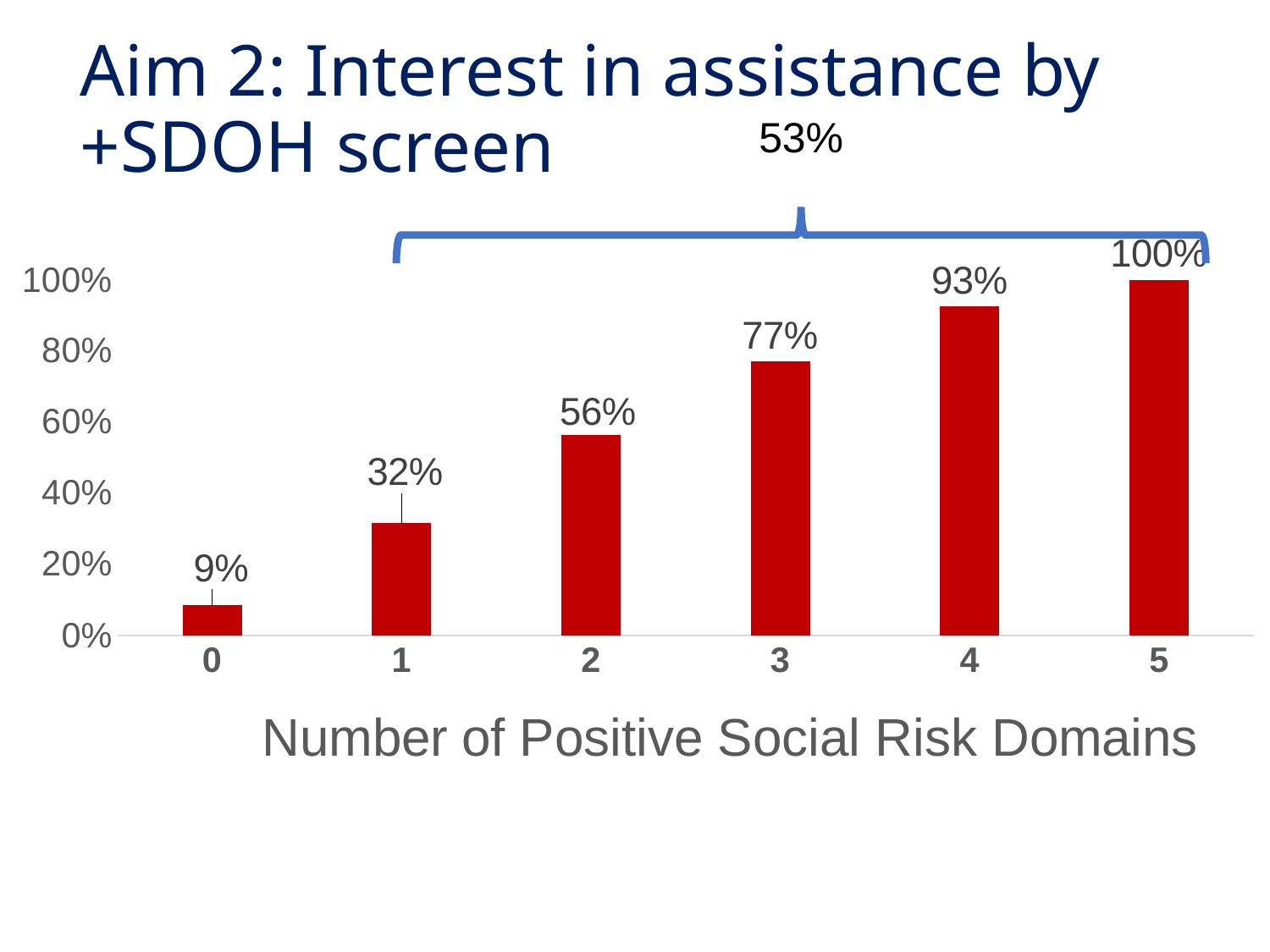
Which number of positive social risk domains has the highest value? 5 Which number of positive social risk domains has the lowest value? 0 What is the value for 3 positive social risk domains? 77% What kind of chart is shown on the slide? bar chart Do the values rise or fall as the number of positive social risk domains increases? rise What is the value for 0 positive social risk domains? 9% What is the value for 4 positive social risk domains? 93% How many categories are shown on the x axis? 6 What is the difference between the values for 2 and 1 positive social risk domains? 24% Is the value for 1 positive social risk domain greater or less than 40%? less Which is larger, the value for 2 or the value for 3 positive social risk domains? 3 What is the difference between the values for 5 and 0 positive social risk domains? 91%